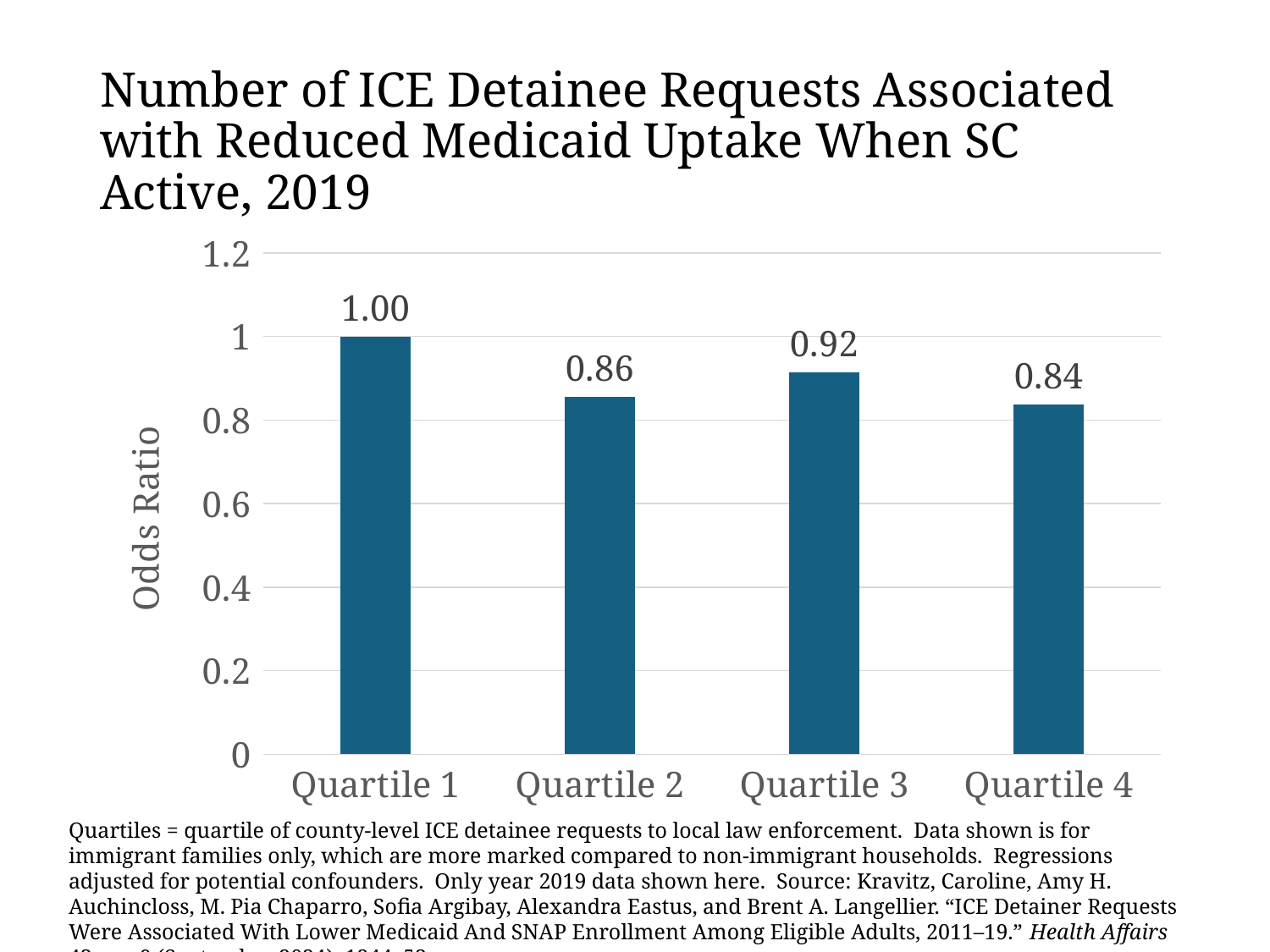
What is the odds ratio for Quartile 2? 0.86 What kind of chart is shown on the slide? Bar chart Is the odds ratio for Quartile 3 greater or less than 0.8? greater Which has a larger odds ratio, Quartile 2 or Quartile 3? Quartile 3 What is the odds ratio for Quartile 4? 0.84 What is the odds ratio for Quartile 1? 1.00 How many quartiles are shown on the chart? 4 Which quartile has the highest odds ratio? Quartile 1 What is the odds ratio for Quartile 3? 0.92 Which quartile has the lowest odds ratio? Quartile 4 What is the label of the vertical axis? Odds Ratio What is the difference between the odds ratios for Quartile 1 and Quartile 4? 0.16